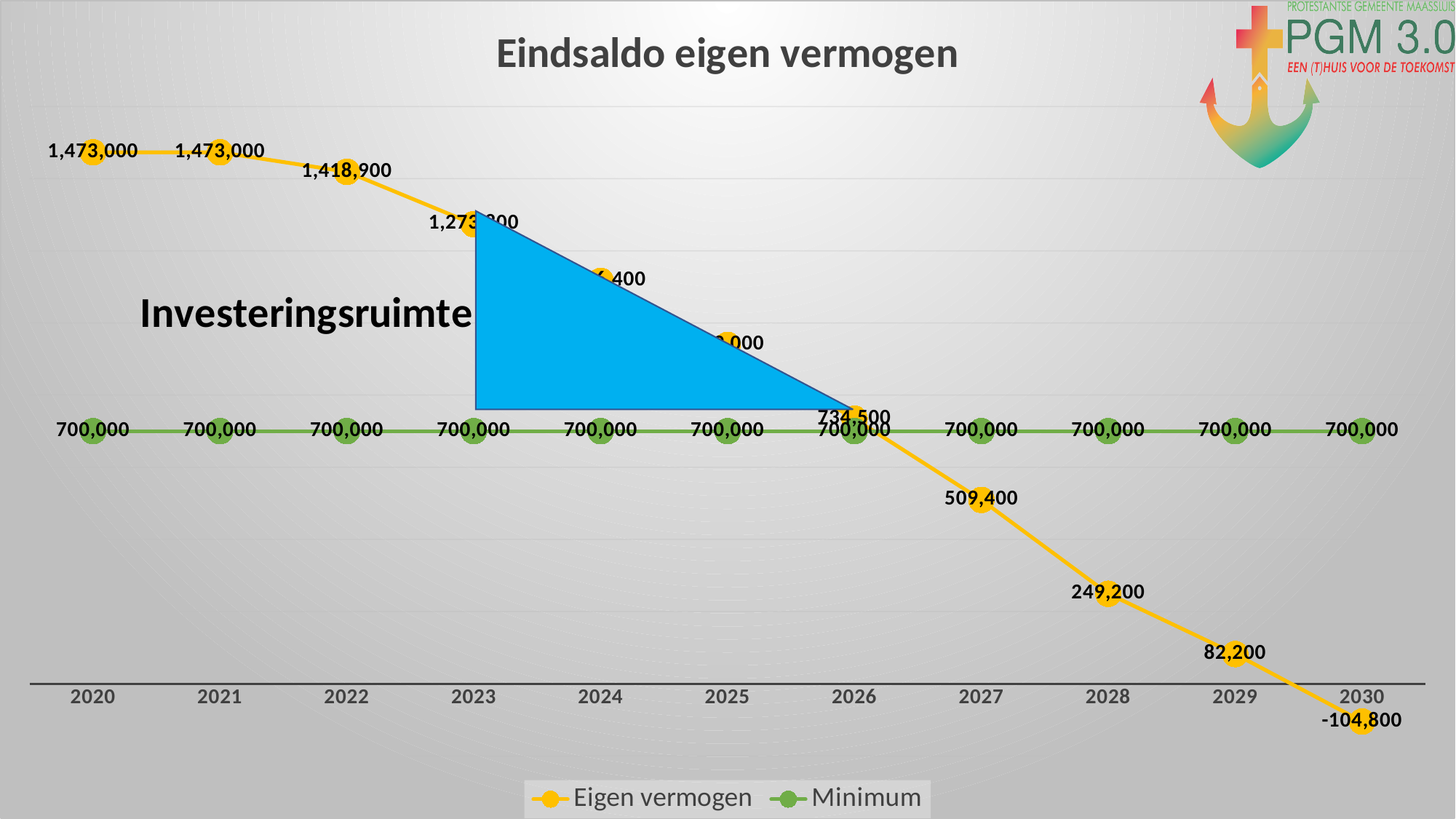
What is the value of Eigen vermogen in 2030? -104,800 In 2026, which is larger: Eigen vermogen or Minimum? Eigen vermogen In which year is Eigen vermogen at its lowest? 2030 How many years are shown on the x axis? 11 What kind of chart is shown on the slide? Line chart What is the value of the Minimum series in 2025? 700,000 What is the value of Eigen vermogen in 2020? 1,473,000 What is the value of Eigen vermogen in 2027? 509,400 What is the difference between Eigen vermogen in 2028 and in 2029? 167,000 Does the Eigen vermogen series rise or fall from 2021 to 2030? Fall What is the difference between Eigen vermogen in 2022 and in 2026? 684,400 How many series does the legend list? 2